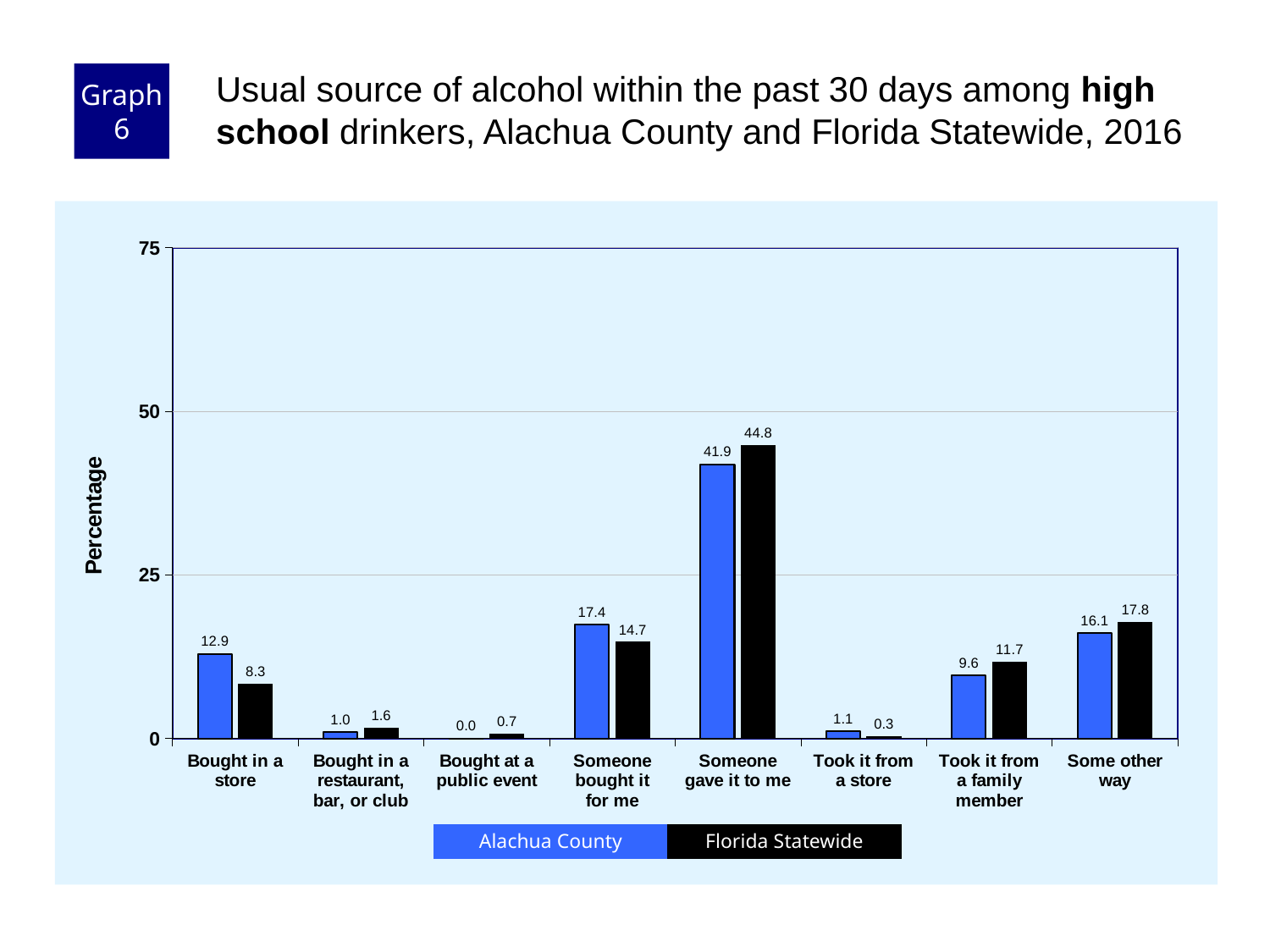
What is the Alachua County value for "Bought at a public event"? 0.0 What is the difference between the Florida Statewide and Alachua County values for "Someone gave it to me"? 2.9 How many categories are shown on the x axis? 8 Which is larger for "Took it from a family member": Alachua County or Florida Statewide? Florida Statewide How many series does the legend list? 2 Which category has the lowest Alachua County value? Bought at a public event Is the Alachua County value for "Someone gave it to me" greater or less than 50? less Which category has the highest Florida Statewide value? Someone gave it to me What kind of chart is shown on the slide? Bar chart What is the difference between the Alachua County and Florida Statewide values for "Someone bought it for me"? 2.7 What is the Florida Statewide value for "Bought in a store"? 8.3 What is the Alachua County value for "Someone gave it to me"? 41.9